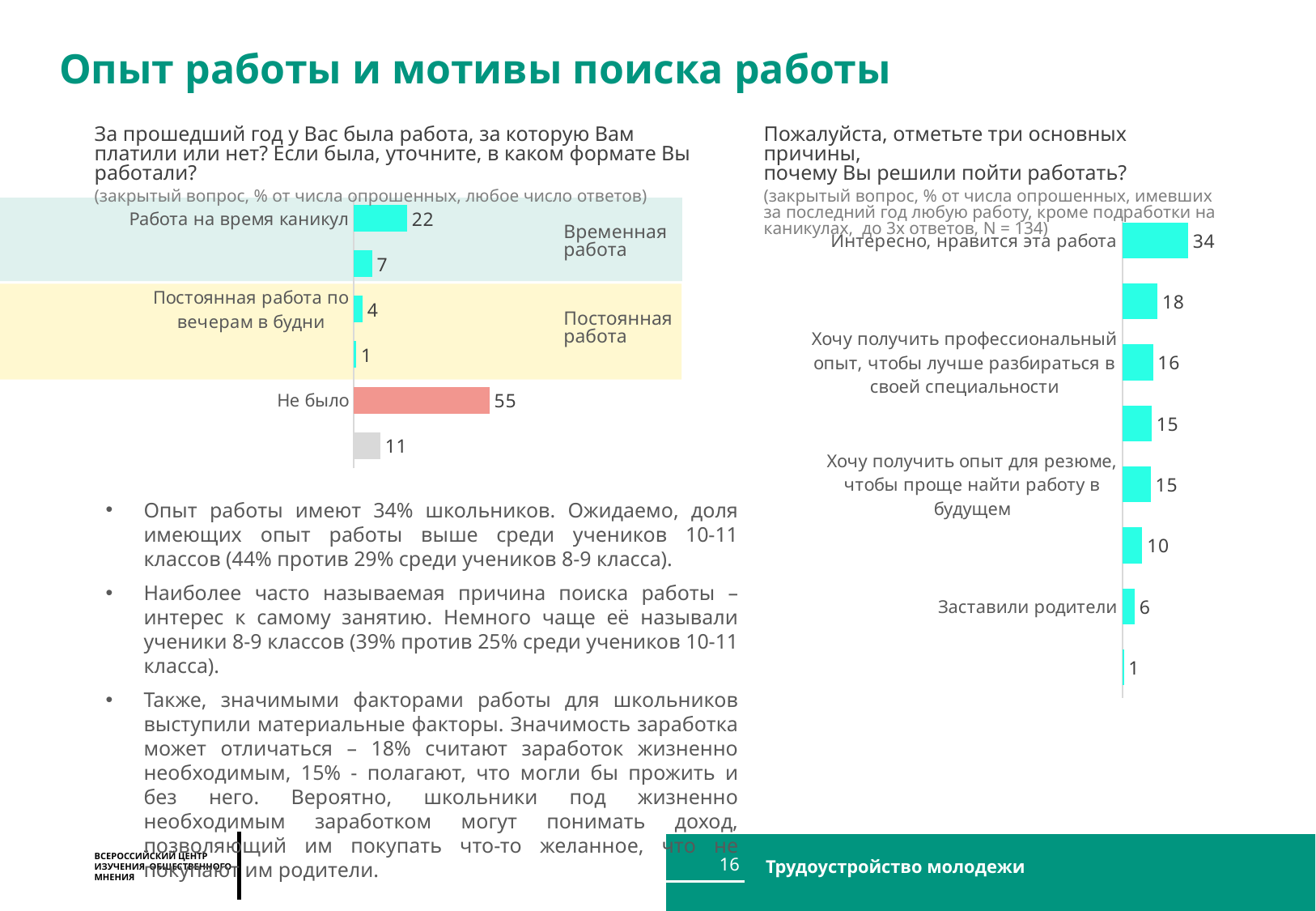
In the left chart (За прошедший год у Вас была работа...), what is the difference between 'Не было' and 'Работа на время каникул'? 33 In the left chart (За прошедший год у Вас была работа...), what is the value for 'Постоянная работа по вечерам в будни'? 4 In the left chart (За прошедший год у Вас была работа...), how many bars are plotted? 6 In the right chart (Пожалуйста, отметьте три основных причины...), which is larger: 'Хочу получить профессиональный опыт, чтобы лучше разбираться в своей специальности' or 'Заставили родители'? Хочу получить профессиональный опыт, чтобы лучше разбираться в своей специальности In the right chart (Пожалуйста, отметьте три основных причины...), what is the difference between 'Интересно, нравится эта работа' and 'Заставили родители'? 28 In the right chart (Пожалуйста, отметьте три основных причины...), what is the value for 'Хочу получить опыт для резюме, чтобы проще найти работу в будущем'? 15 In the right chart (Пожалуйста, отметьте три основных причины...), what is the value for 'Заставили родители'? 6 In the left chart (За прошедший год у Вас была работа...), what is the value for 'Не было'? 55 In the right chart (Пожалуйста, отметьте три основных причины...), what is the value for 'Интересно, нравится эта работа'? 34 In the left chart (За прошедший год у Вас была работа...), what is the value for 'Работа на время каникул'? 22 In the left chart (За прошедший год у Вас была работа...), which category has the highest value? Не было What type of chart is the right chart (Пожалуйста, отметьте три основных причины...)? Bar chart